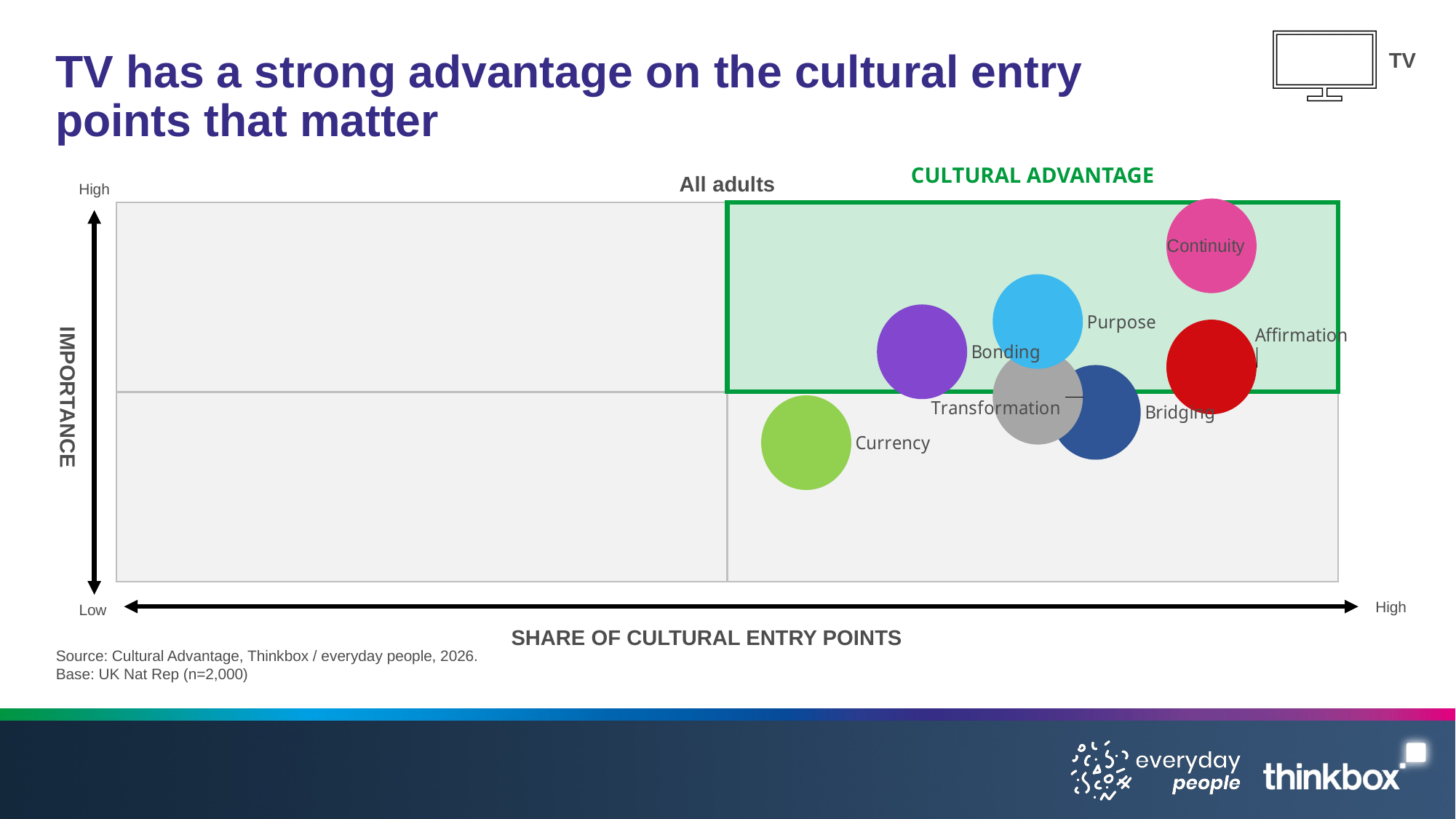
Which has a higher share of cultural entry points, Bridging or Currency? Bridging What kind of chart is shown on the slide? Bubble chart Is the Currency bubble inside the green 'Cultural Advantage' box? No Which cultural entry point has the highest importance? Continuity Which cultural entry point has the lowest importance? Currency Which has higher importance, Purpose or Bonding? Purpose Which cultural entry point has the lowest share of cultural entry points? Currency What is the label on the vertical axis of the chart? IMPORTANCE What is the label on the horizontal axis of the chart? SHARE OF CULTURAL ENTRY POINTS How many bubbles are plotted on the chart? 7